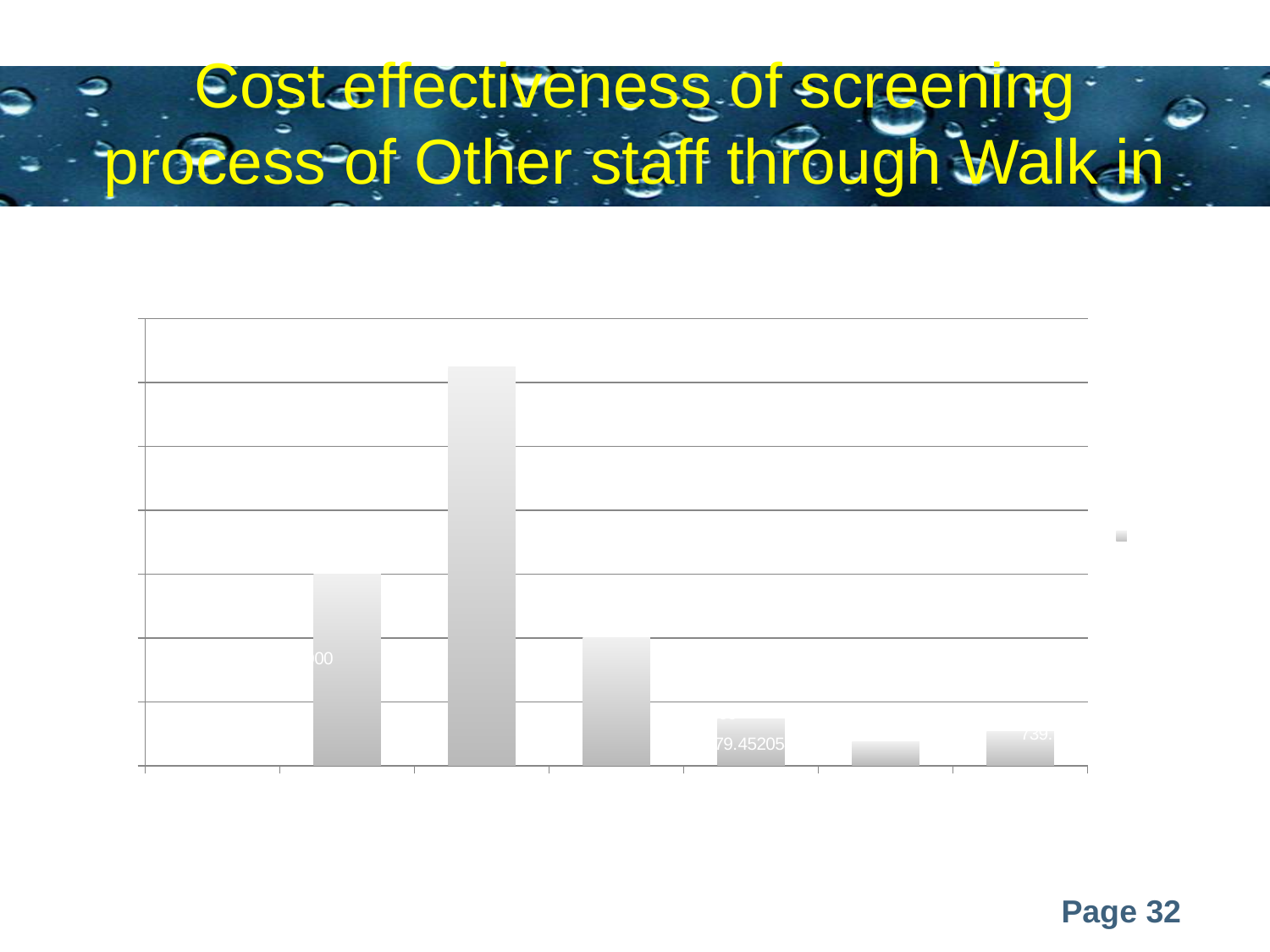
Which is taller, the fourth bar or the sixth bar from the left? the fourth bar Which bar is the tallest in the chart, counting from the left? the second bar Which is taller, the second bar or the first bar from the left? the second bar Which is taller, the first bar or the third bar from the left? the first bar Do the bar heights consistently decrease from left to right across the chart? no What is the title shown at the top of the slide? Cost effectiveness of screening process of Other staff through Walk in What colour are the bars in the chart? grey Which bar is the shortest in the chart, counting from the left? the fifth bar What kind of chart is shown on the slide? bar chart How many bars are plotted in the chart? 6